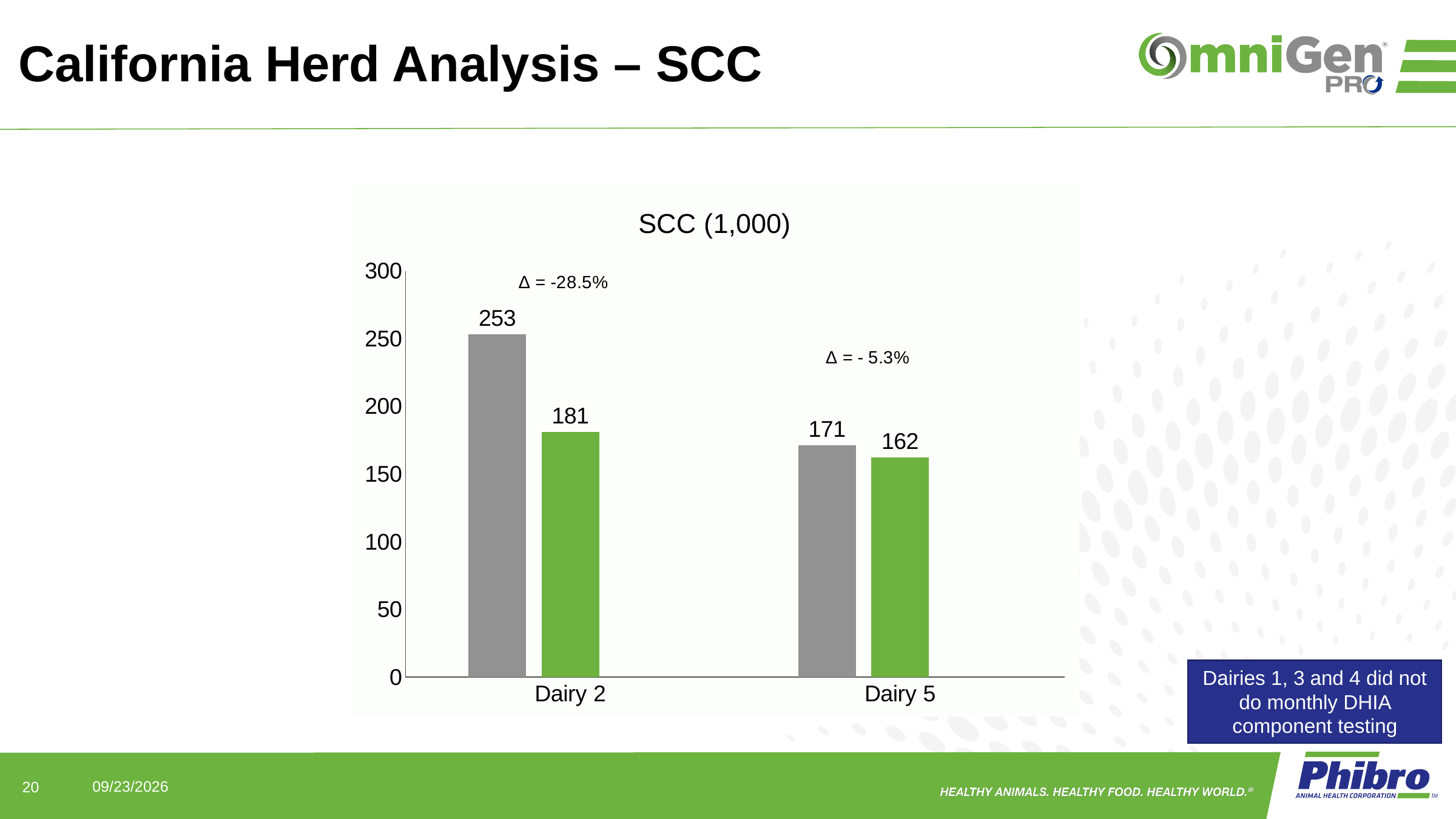
Which is larger, the gray bar for Dairy 5 or the green bar for Dairy 2? Green bar for Dairy 2 What is the value of the green bar for Dairy 2? 181 Which bar has the highest value in the chart? Gray bar for Dairy 2 What is the difference between the gray and green bars for Dairy 2? 72 What is the value of the gray bar for Dairy 5? 171 Which bar has the lowest value in the chart? Green bar for Dairy 5 What type of chart is shown on the slide? Bar chart How many dairies are shown on the x axis of the chart? 2 What is the value of the gray bar for Dairy 2? 253 What percentage change (Δ) is annotated above the Dairy 2 bars? -28.5% What is the value of the green bar for Dairy 5? 162 What is the difference between the gray and green bars for Dairy 5? 9